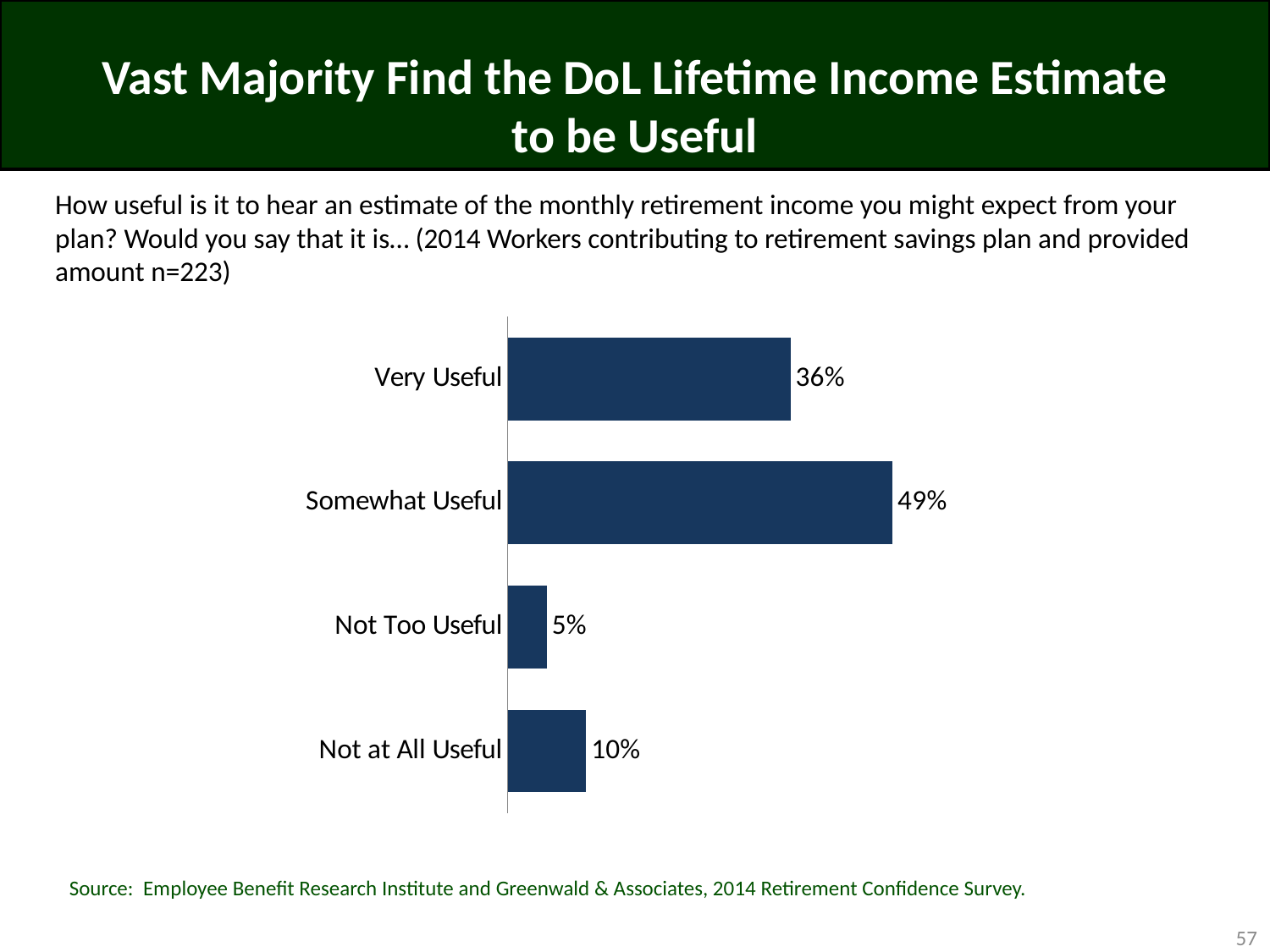
How many response categories are shown in the chart? 4 What is the difference in percentage points between Not at All Useful and Not Too Useful? 5 What is the difference in percentage points between Somewhat Useful and Very Useful? 13 What percentage of respondents said the estimate is Somewhat Useful? 49% What is the combined percentage of respondents who said Very Useful or Somewhat Useful? 85% What percentage of respondents said the estimate is Not at All Useful? 10% What percentage of respondents said the estimate is Not Too Useful? 5% Which response category has the lowest percentage? Not Too Useful Which response category has the highest percentage? Somewhat Useful What kind of chart is shown on the slide? Bar chart Which is larger, the percentage for Very Useful or for Not at All Useful? Very Useful What percentage of respondents said the estimate is Very Useful? 36%